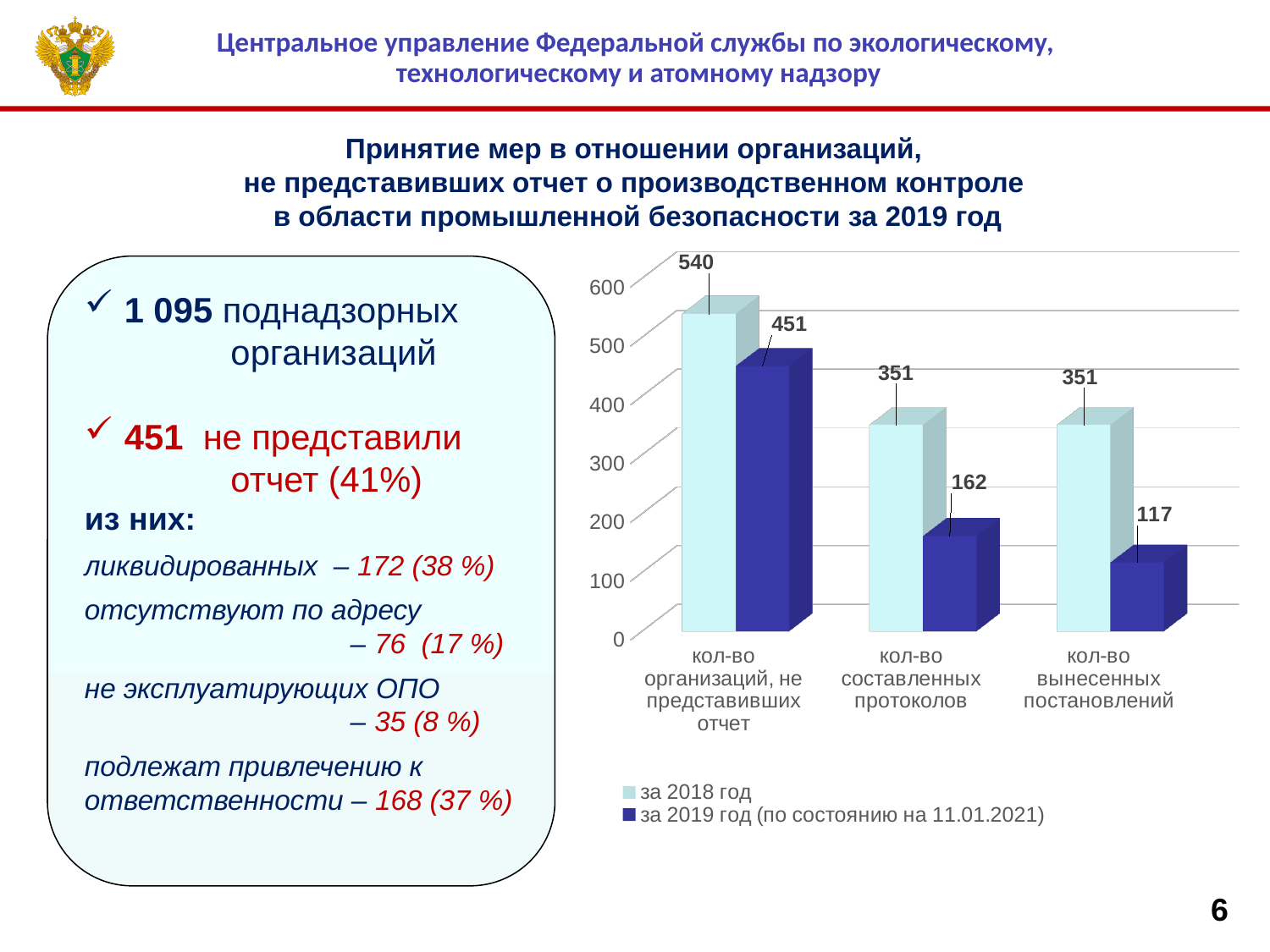
Which is larger: the 2019 value for 'кол-во составленных протоколов' or the 2019 value for 'кол-во вынесенных постановлений'? кол-во составленных протоколов What is the value for 'кол-во составленных протоколов' in the 'за 2019 год (по состоянию на 11.01.2021)' series? 162 What is the value for 'кол-во вынесенных постановлений' in the 'за 2018 год' series? 351 What kind of chart is shown on the slide? bar chart How many series does the chart legend list? 2 What is the difference between the 2018 and 2019 values for 'кол-во организаций, не представивших отчет'? 89 What is the value for 'кол-во вынесенных постановлений' in the 'за 2019 год (по состоянию на 11.01.2021)' series? 117 Which category has the highest value in the 'за 2019 год (по состоянию на 11.01.2021)' series? кол-во организаций, не представивших отчет What is the value for 'кол-во организаций, не представивших отчет' in the 'за 2018 год' series? 540 How many categories are shown on the x axis of the chart? 3 Which category has the lowest value in the 'за 2019 год (по состоянию на 11.01.2021)' series? кол-во вынесенных постановлений What is the difference between the 2018 and 2019 values for 'кол-во составленных протоколов'? 189